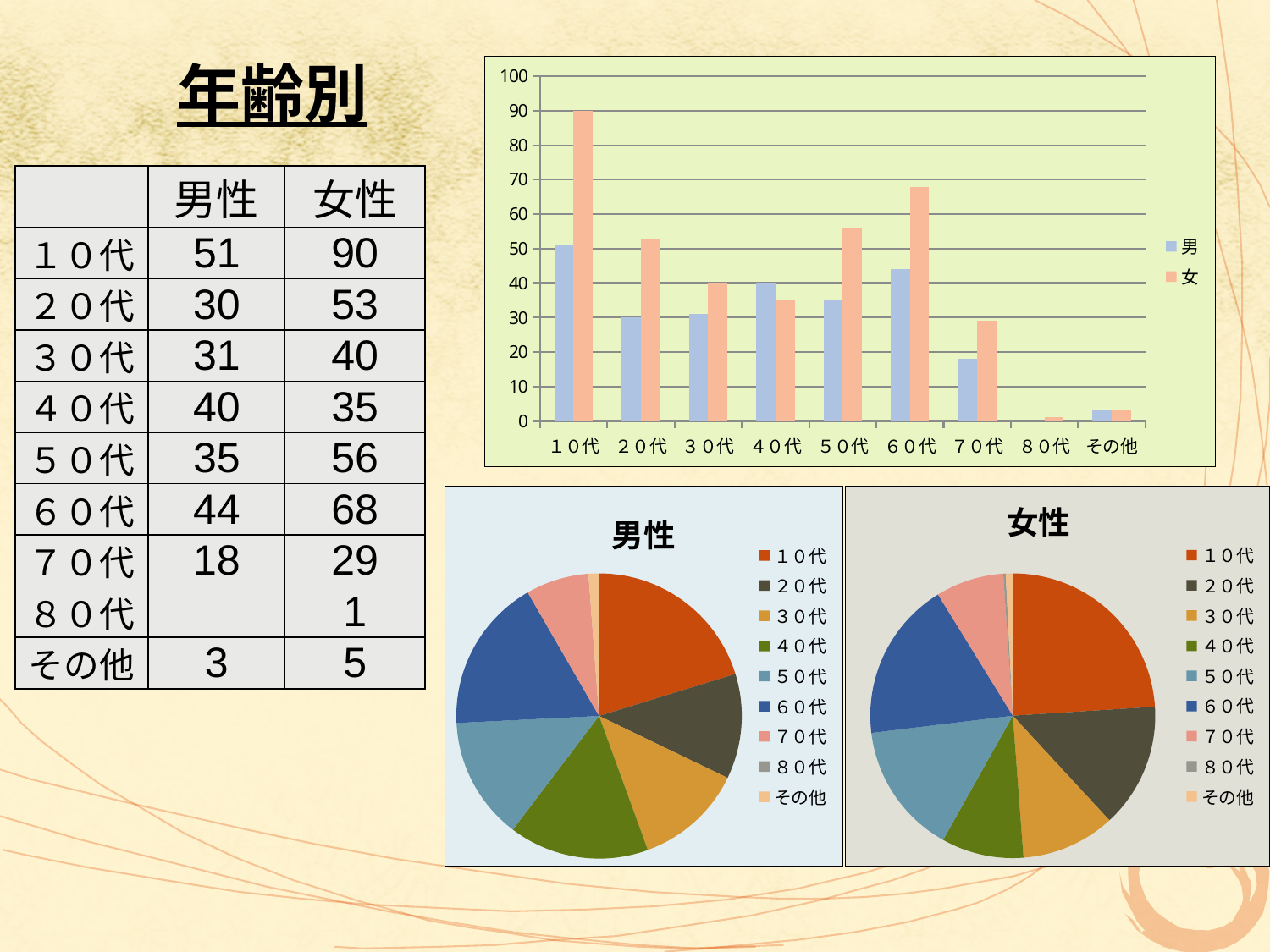
In the top bar chart, how many age categories are shown on the x axis? 9 In the top bar chart, which category has the lowest value for 女? 80代 In the top bar chart, is the value for 女 in 60代 greater or less than 60? greater According to the slide, what is the value for 女性 in 60代? 68 In the top bar chart, is the value for 男 in 70代 greater or less than 20? less According to the slide, what is the difference between 女性 and 男性 in 10代? 39 In the pie chart titled 女性, which age group has the largest slice? 10代 In the top bar chart, which category has the highest value for 男? 10代 In the top bar chart, which category has the highest value for 女? 10代 In the top bar chart, how many series does the legend list? 2 What kind of chart is the top chart on the slide? bar chart In the top bar chart, which is larger in 40代, 男 or 女? 男